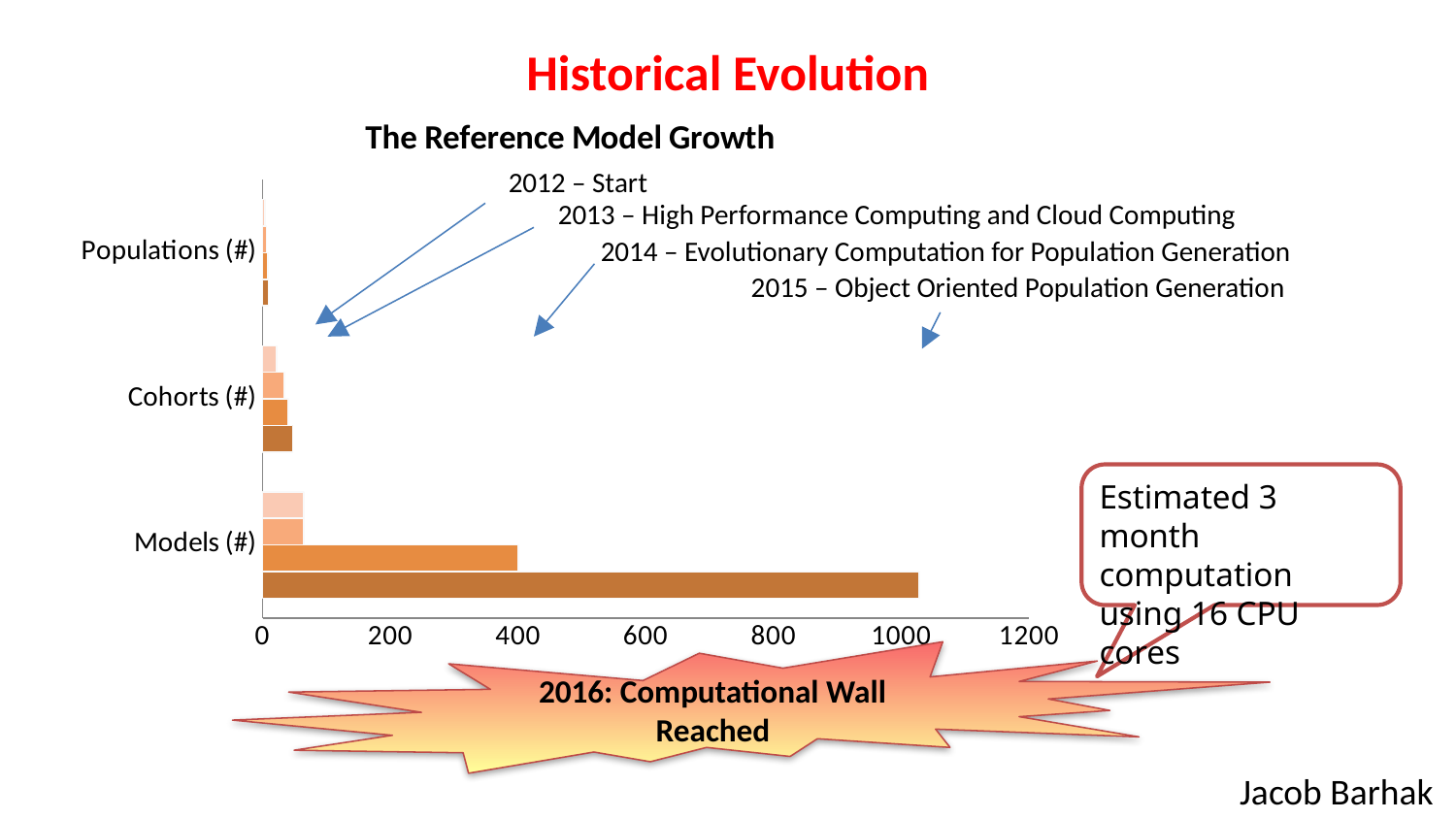
Within the Models (#) category, do the bars get longer or shorter going from the top bar to the bottom bar? longer How many bars are drawn for each category in the chart? 4 Is the second-longest bar for Models (#) greater or less than 600? less Are all the bars for Populations (#) greater or less than 200? less Which category has a larger longest bar, Models (#) or Cohorts (#)? Models (#) What kind of chart is shown on the slide? bar chart Is the longest bar for Models (#) greater or less than 800? greater What is the title of the chart? The Reference Model Growth What is the highest value shown on the horizontal axis of the chart? 1200 Which category has the longest bar in the chart? Models (#) How many categories are shown on the vertical axis of the chart? 3